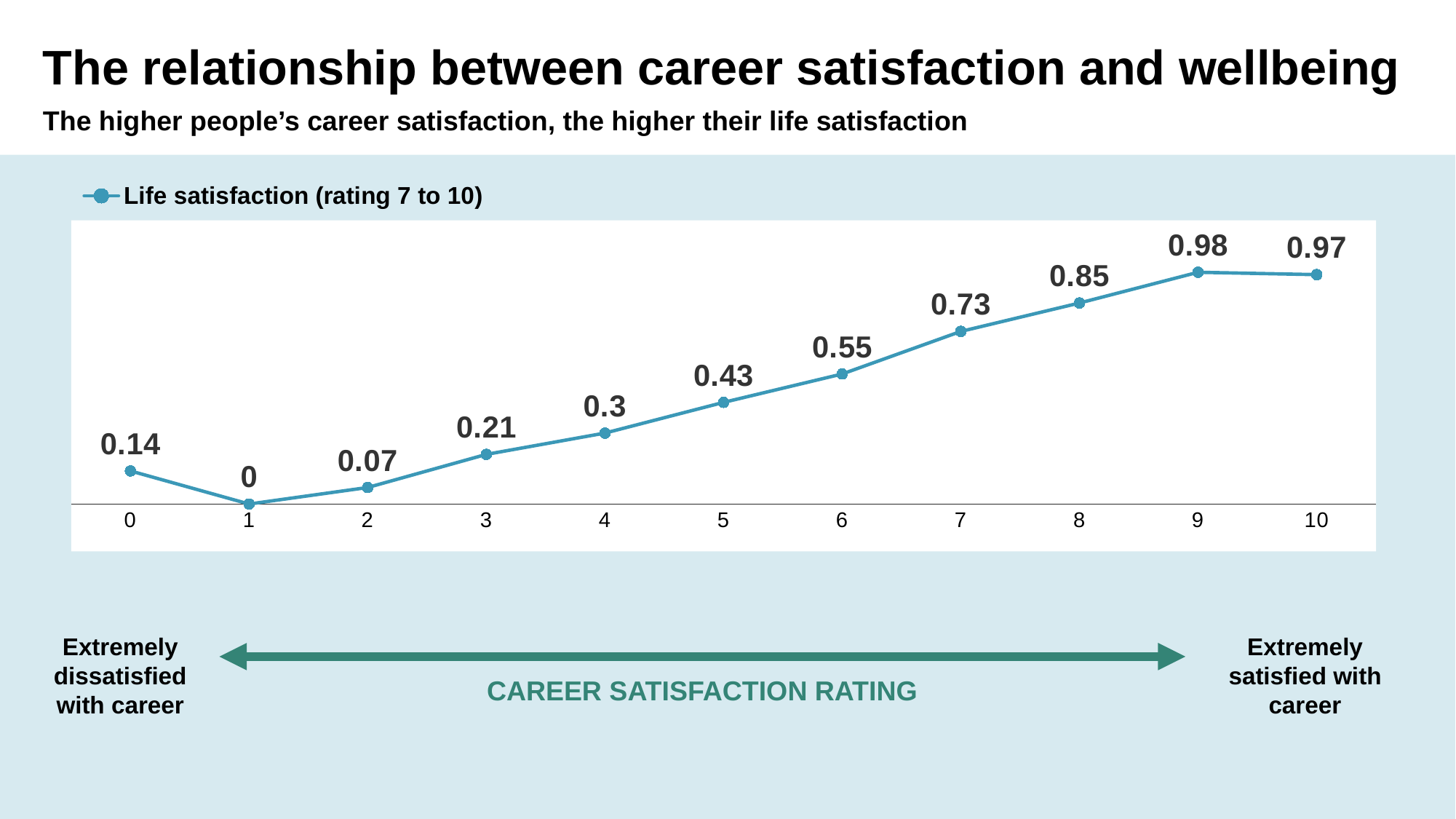
What kind of chart is shown on the slide? Line chart Which has a higher life satisfaction value: career satisfaction rating 4 or rating 6? Rating 6 What is the name of the series shown in the legend? Life satisfaction (rating 7 to 10) What is the life satisfaction value at career satisfaction rating 8? 0.85 What is the life satisfaction value at career satisfaction rating 5? 0.43 What is the difference between the life satisfaction values at ratings 7 and 3? 0.52 At which career satisfaction rating is life satisfaction lowest? 1 How many career satisfaction rating points are plotted on the chart? 11 At which career satisfaction rating is life satisfaction highest? 9 How many series does the legend list? 1 What is the life satisfaction value at career satisfaction rating 0? 0.14 What is the difference between the life satisfaction values at ratings 9 and 10? 0.01